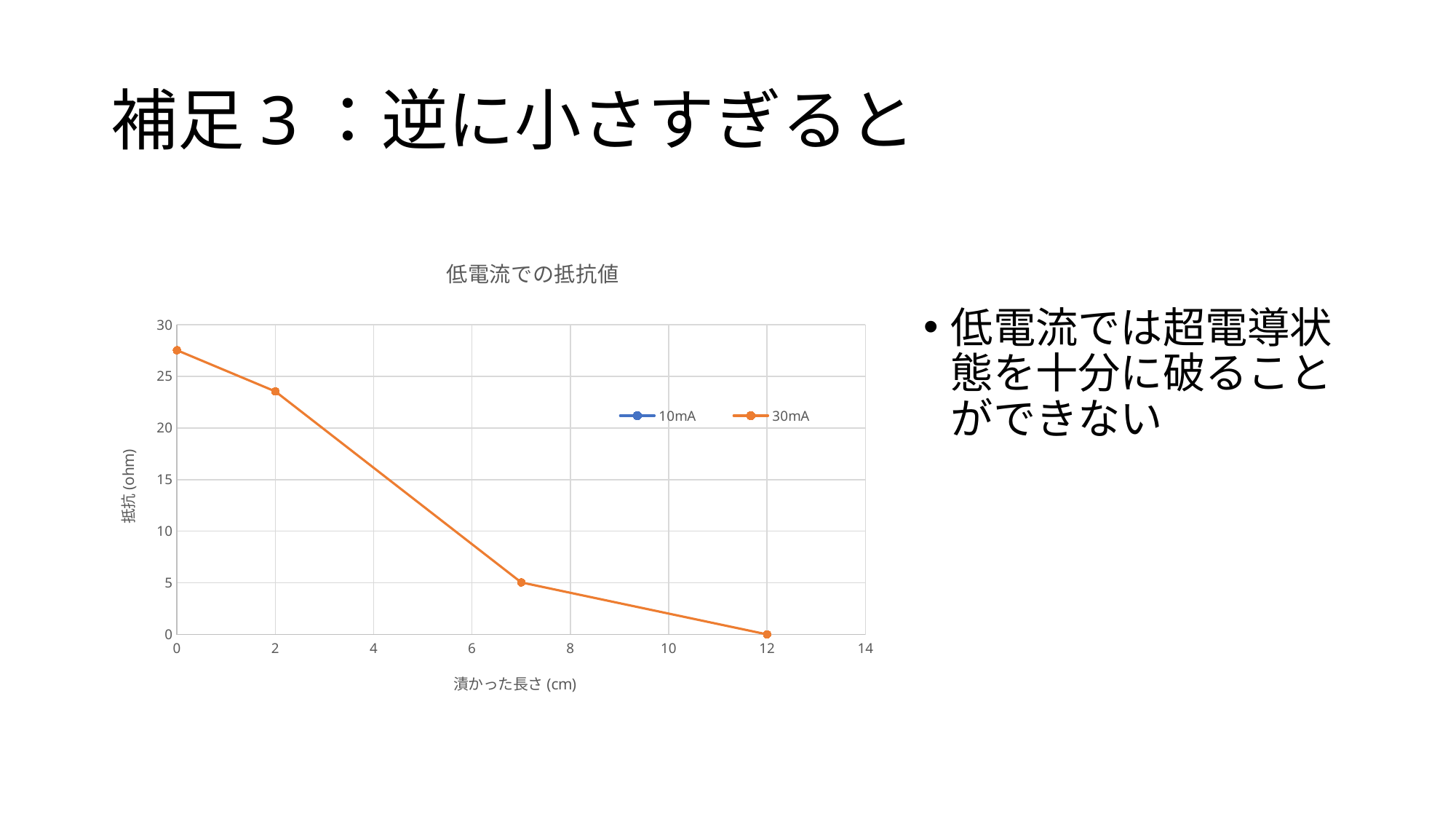
What are the two series names in the legend? 10mA and 30mA How many series does the chart legend list? 2 What is the title of the chart? 低電流での抵抗値 At which immersed length is the resistance for the 30mA series highest? 0 cm Does the resistance (抵抗) rise or fall as the immersed length (漬かった長さ) increases? fall Which has the larger resistance for the 30mA series: 2 cm or 7 cm? 2 cm Is the resistance for the 30mA series at 2 cm greater or less than 20? greater What kind of chart is shown on the slide? line chart How many data points are plotted on the 30mA line? 4 Is the resistance for the 30mA series at 0 cm greater or less than 25? greater